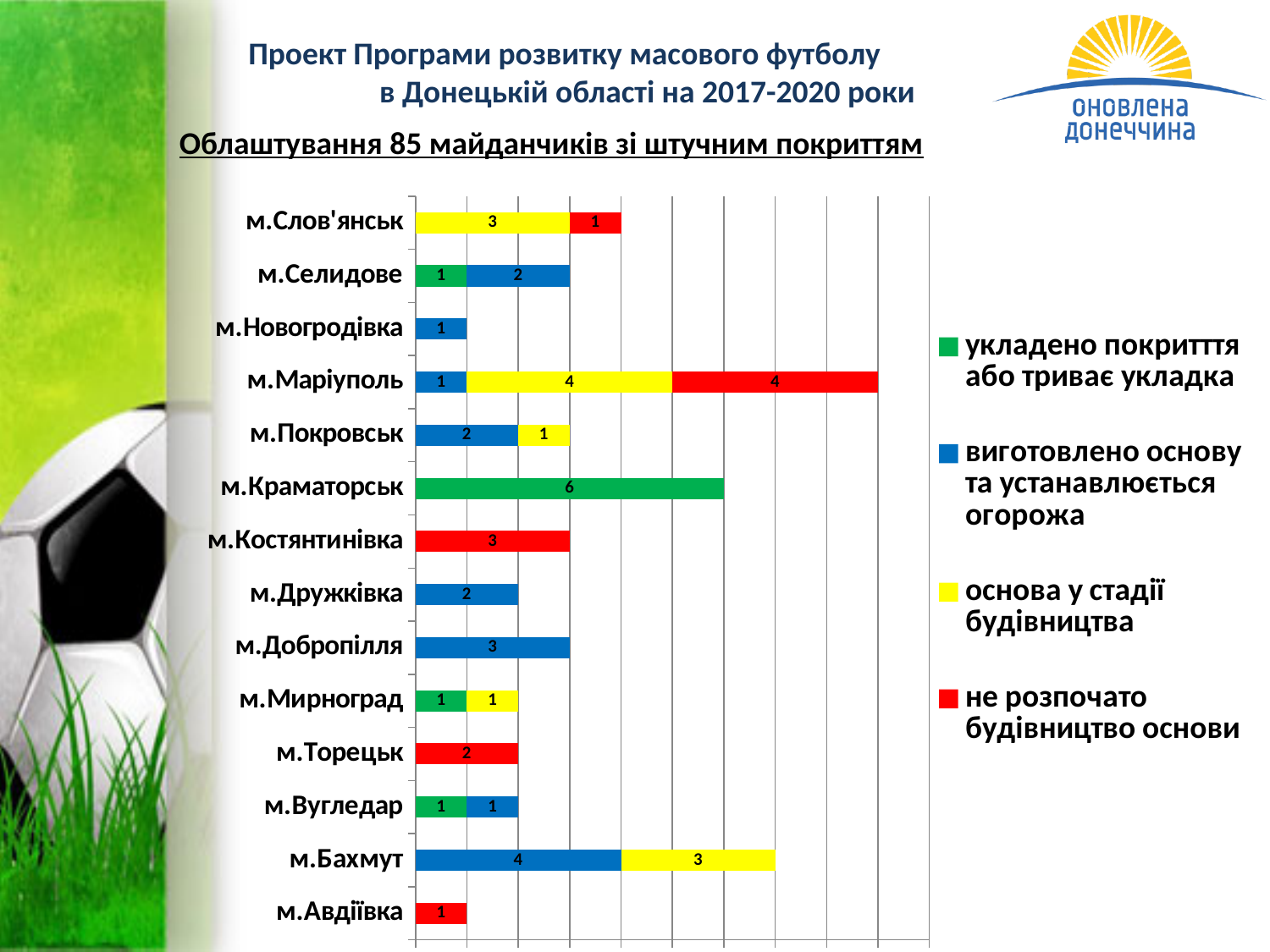
What is the total of the stacked bar for м.Бахмут? 7 Which city has the largest 'укладено покриття або триває укладка' segment? м.Краматорськ Which is larger: the total for м.Слов'янськ or the total for м.Селидове? м.Слов'янськ How many series does the legend list? 4 How many cities are shown on the chart? 14 What kind of chart is shown on the slide? Stacked bar chart Which city has the highest total across all segments? м.Маріуполь What is the value of the 'не розпочато будівництво основи' segment for м.Маріуполь? 4 What is the value of the 'укладено покриття або триває укладка' segment for м.Краматорськ? 6 What is the difference between the 'основа у стадії будівництва' values for м.Маріуполь and м.Бахмут? 1 What is the total of the stacked bar for м.Маріуполь? 9 What is the value of the 'виготовлено основу та устанавлюється огорожа' segment for м.Бахмут? 4